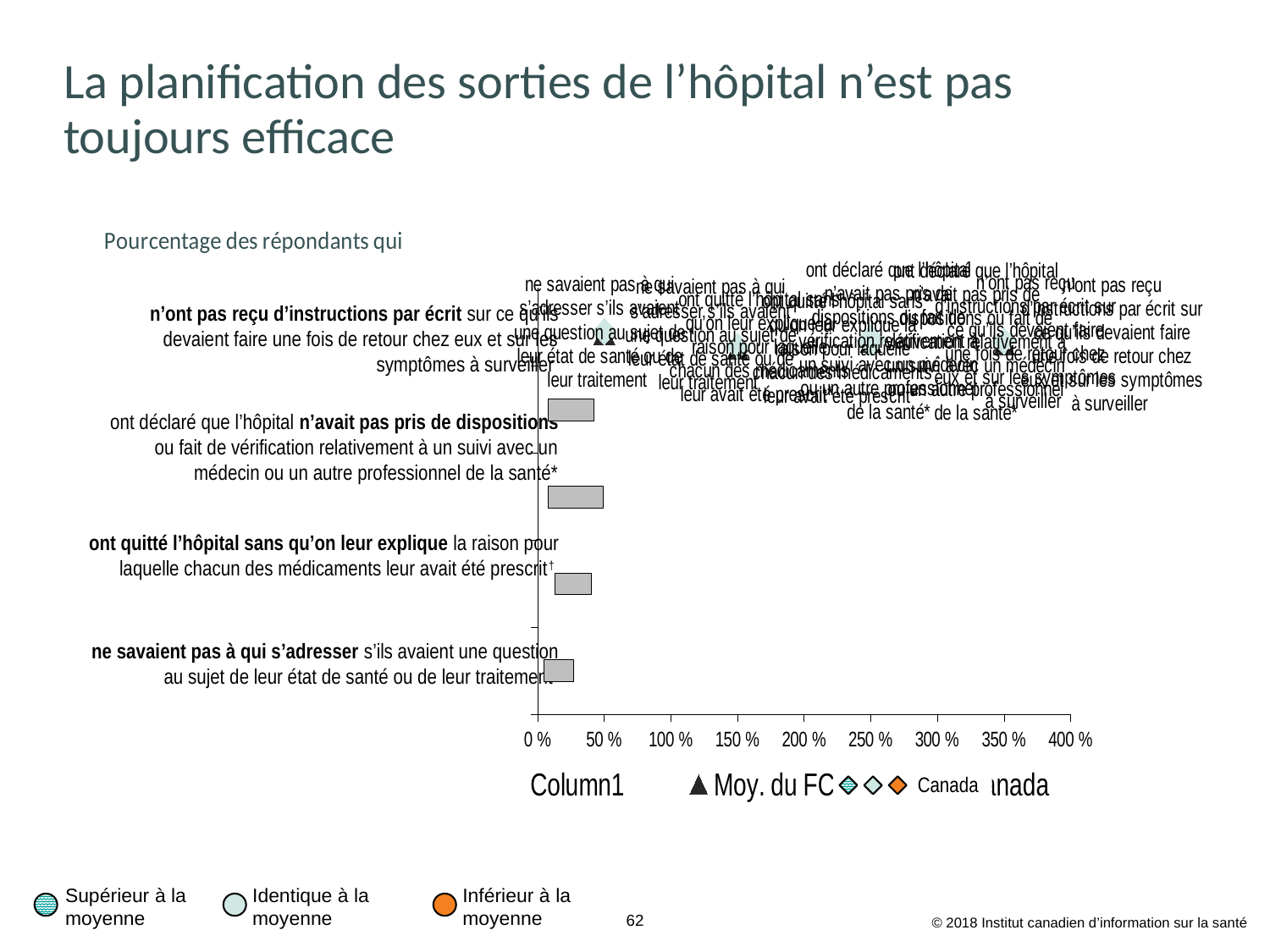
Is the value for 'ne savaient pas à qui s'adresser' greater or less than 50 %? less Which is larger: the bar for 'ont déclaré que l'hôpital n'avait pas pris de dispositions' or the bar for 'ne savaient pas à qui s'adresser'? ont déclaré que l'hôpital n'avait pas pris de dispositions Is the value for 'n'ont pas reçu d'instructions par écrit' greater or less than 50 %? less What is the title of the slide containing the chart? La planification des sorties de l'hôpital n'est pas toujours efficace Is the value for 'ont quitté l'hôpital sans qu'on leur explique' greater or less than 100 %? less Which is larger: the bar for 'n'ont pas reçu d'instructions par écrit' or the bar for 'ne savaient pas à qui s'adresser'? n'ont pas reçu d'instructions par écrit What kind of chart is shown on the slide? bar chart Which category has the shortest bar? ne savaient pas à qui s'adresser s'ils avaient une question au sujet de leur état de santé ou de leur traitement What is the highest value shown on the chart's x axis? 400 % How many categories are plotted in the chart? 4 Which category has the longest bar? ont déclaré que l'hôpital n'avait pas pris de dispositions ou fait de vérification relativement à un suivi avec un médecin ou un autre professionnel de la santé